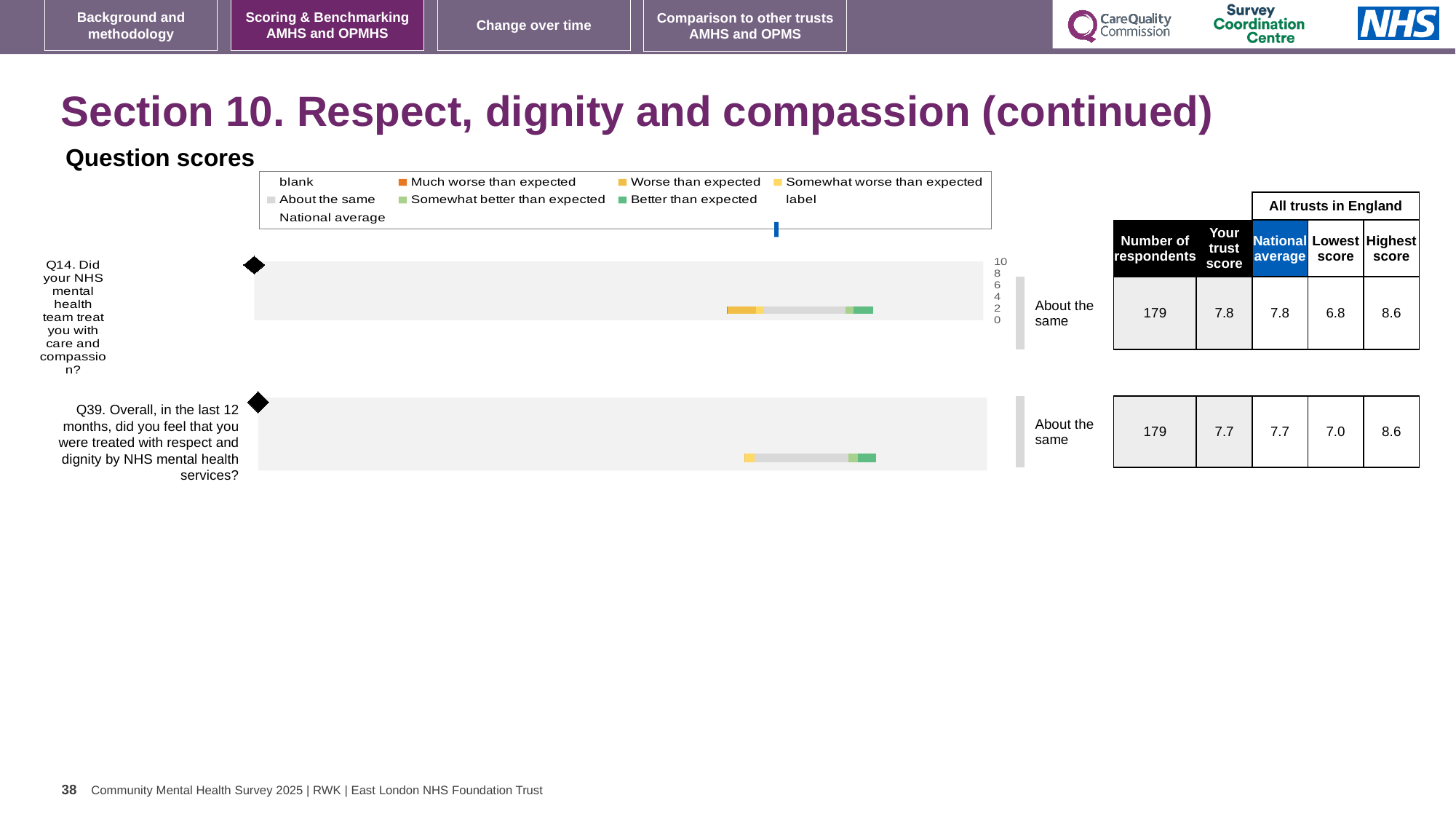
What is the highest score among all trusts in England for Q14? 8.6 Which legend entry is shown in orange? Much worse than expected What is the difference between the trust score and the lowest score for Q14? 1.0 What is the difference between the highest score and the lowest score for Q39? 1.6 What is the number of respondents for Q14 (Did your NHS mental health team treat you with care and compassion?)? 179 What is the national average score for Q14? 7.8 What is the lowest score among all trusts in England for Q39? 7.0 Which question has the higher trust score, Q14 or Q39? Q14 How many questions are plotted on the slide? 2 What is the trust score for Q39 (treated with respect and dignity by NHS mental health services)? 7.7 What kind of chart is used to show the question scores? Bar chart What benchmark category is shown for Q39? About the same